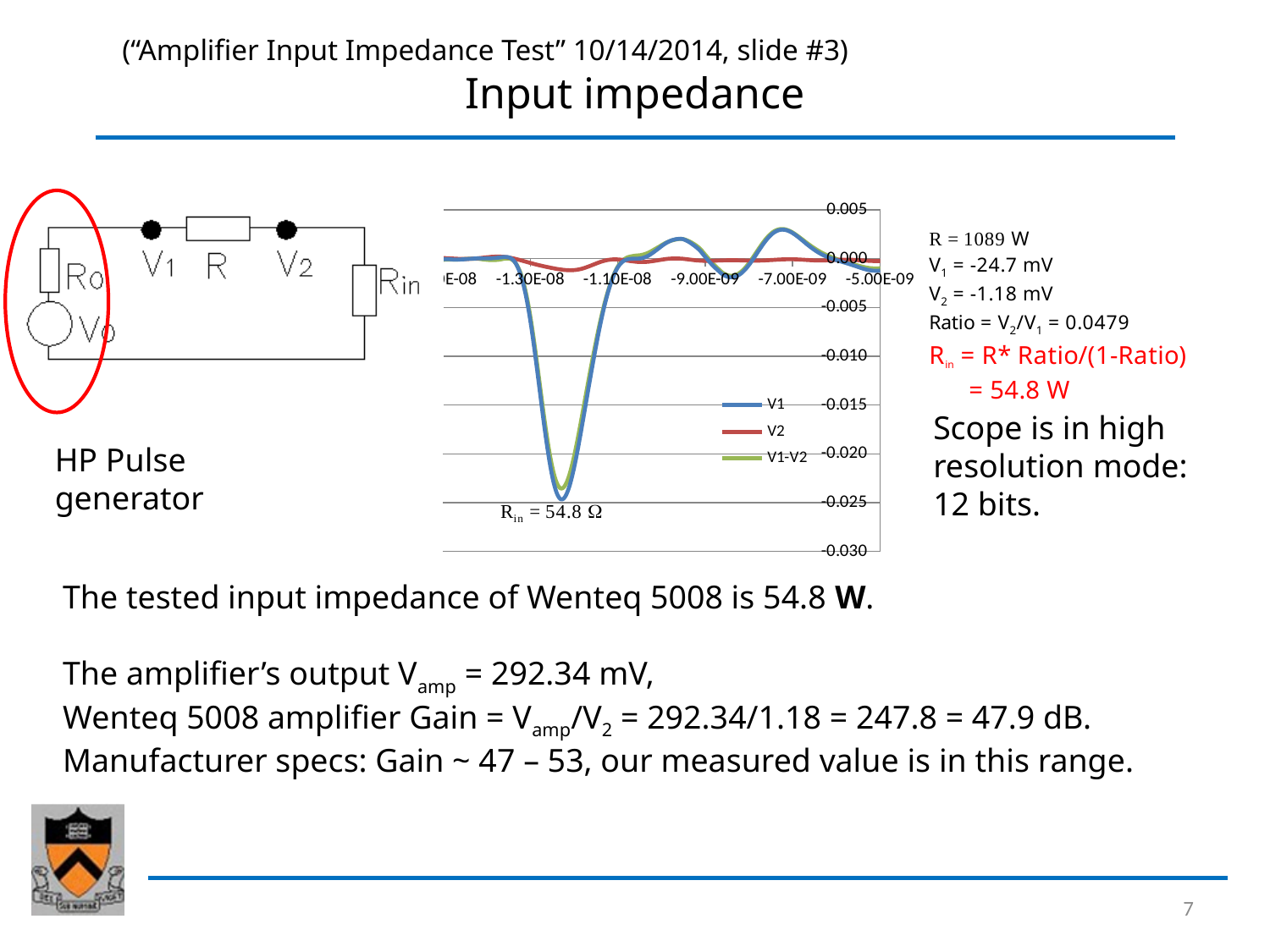
Is the value of the V1 series at -5.00E-09 greater or less than -0.005? greater Is the minimum value reached by the V2 series greater or less than -0.005? greater What kind of chart is shown on the slide? line chart How many series does the chart's legend list? 3 Which series stays closest to zero across the whole chart? V2 What is the highest tick value shown on the chart's y axis? 0.005 What text annotation is printed inside the chart area? Rin = 54.8 Ω What is the lowest tick value shown on the chart's y axis? -0.030 At the large dip near -1.10E-08, which series has the larger (less negative) value, V1 or V2? V2 Is the minimum value reached by the V1 series greater or less than -0.020? less What are the series names listed in the chart's legend? V1, V2, V1-V2